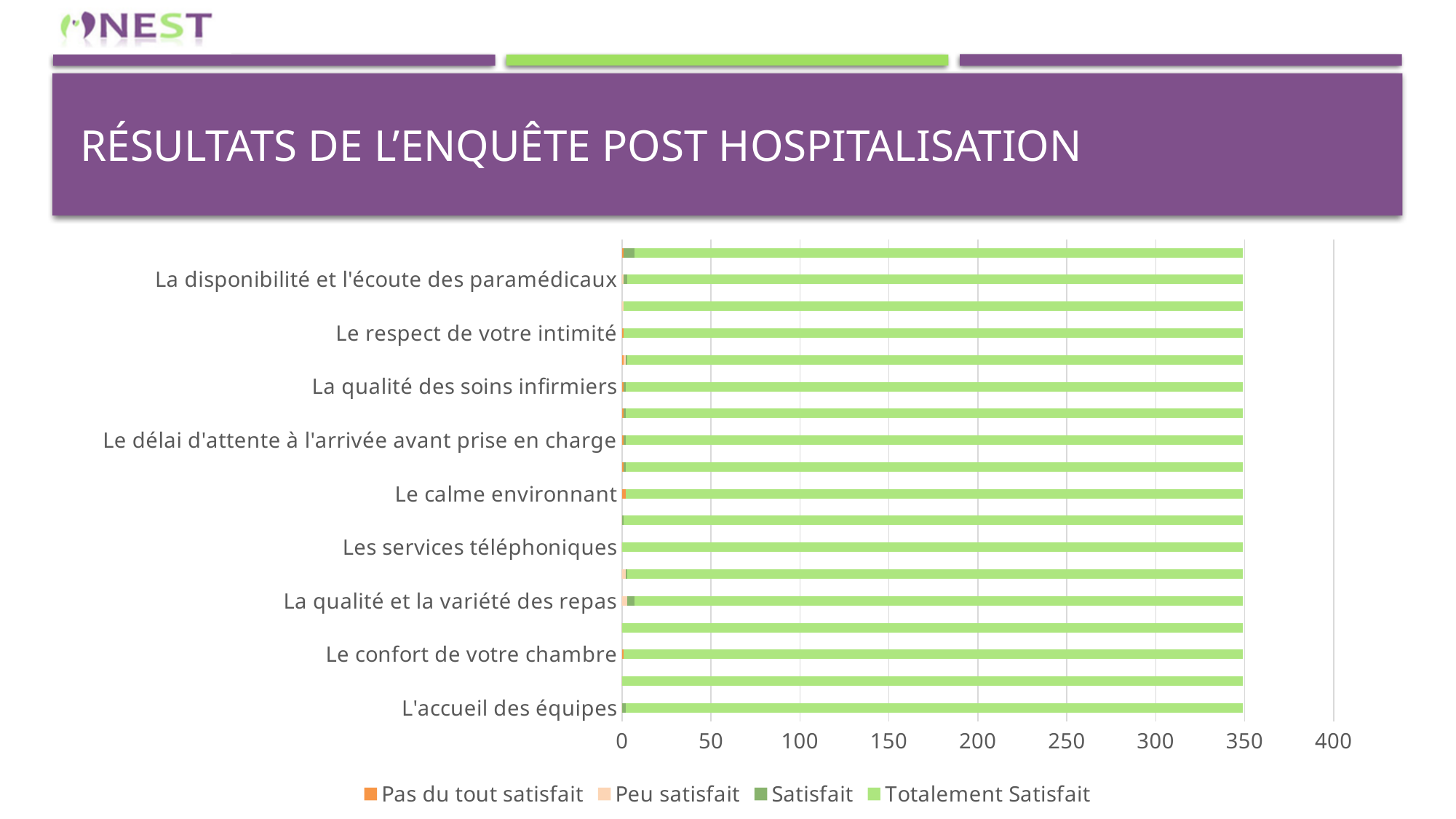
How many series does the chart legend list? 4 Is the total bar length for "Le calme environnant" greater or less than 400? less What is the highest value shown on the horizontal axis of the chart? 400 Which legend entry is shown in light green in the chart? Totalement Satisfait Is the total bar length for "La qualité et la variété des repas" greater or less than 400? less Is the total bar length for "L'accueil des équipes" greater or less than 300? greater What kind of chart is shown on the slide? bar chart